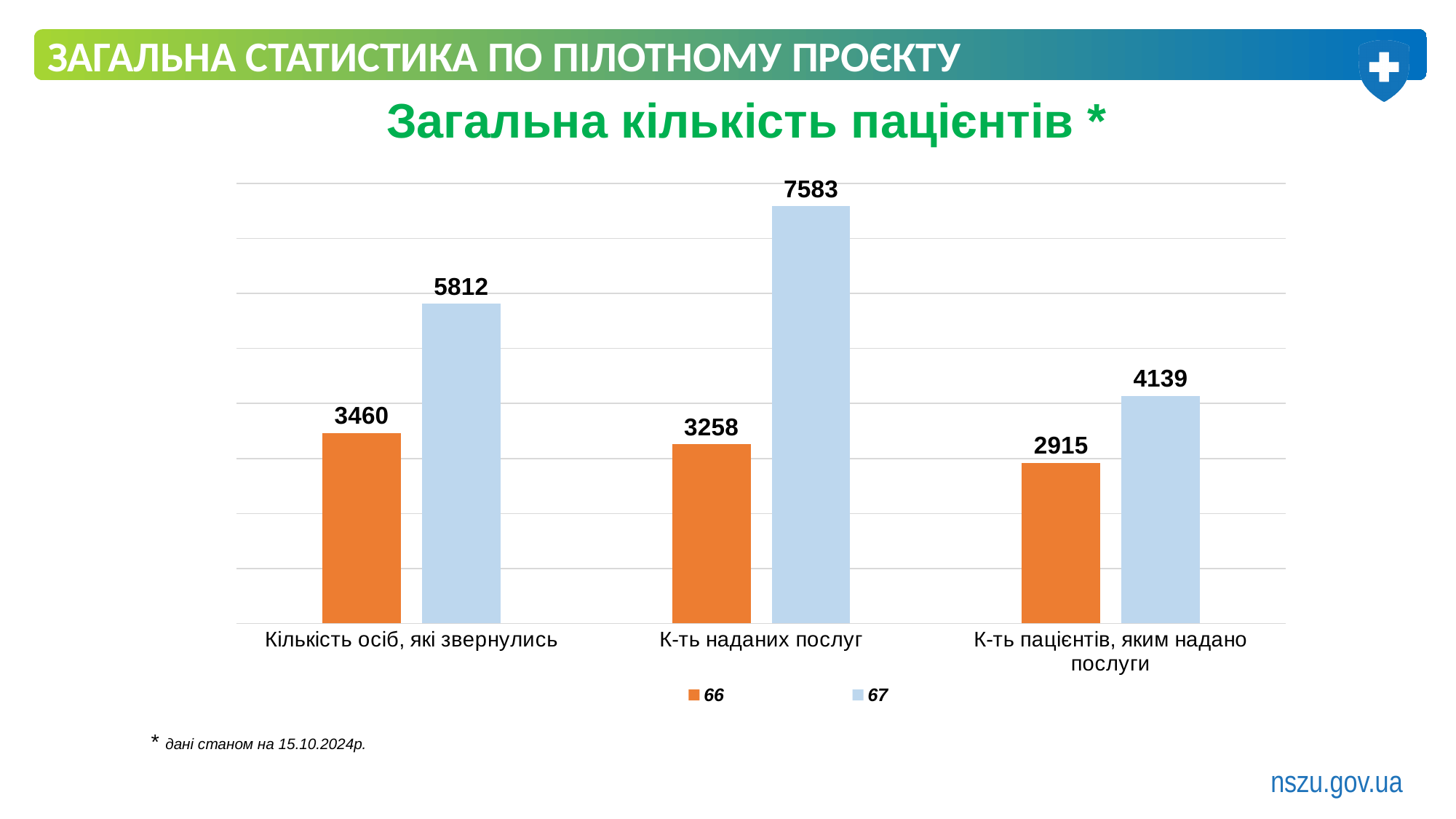
How many categories are shown on the x axis? 3 How many series does the legend list? 2 What is the value for series 66 in the category "К-ть пацієнтів, яким надано послуги"? 2915 Which is larger: series 66 for "Кількість осіб, які звернулись" or series 66 for "К-ть наданих послуг"? Кількість осіб, які звернулись Which category has the highest value for series 67? К-ть наданих послуг What is the value for series 67 in the category "К-ть наданих послуг"? 7583 Which category has the lowest value for series 66? К-ть пацієнтів, яким надано послуги What is the difference between series 67 and series 66 in the category "К-ть наданих послуг"? 4325 What is the value for series 66 in the category "Кількість осіб, які звернулись"? 3460 What kind of chart is shown on the slide? Bar chart What is the value for series 67 in the category "К-ть пацієнтів, яким надано послуги"? 4139 What is the difference between series 67 and series 66 in the category "Кількість осіб, які звернулись"? 2352